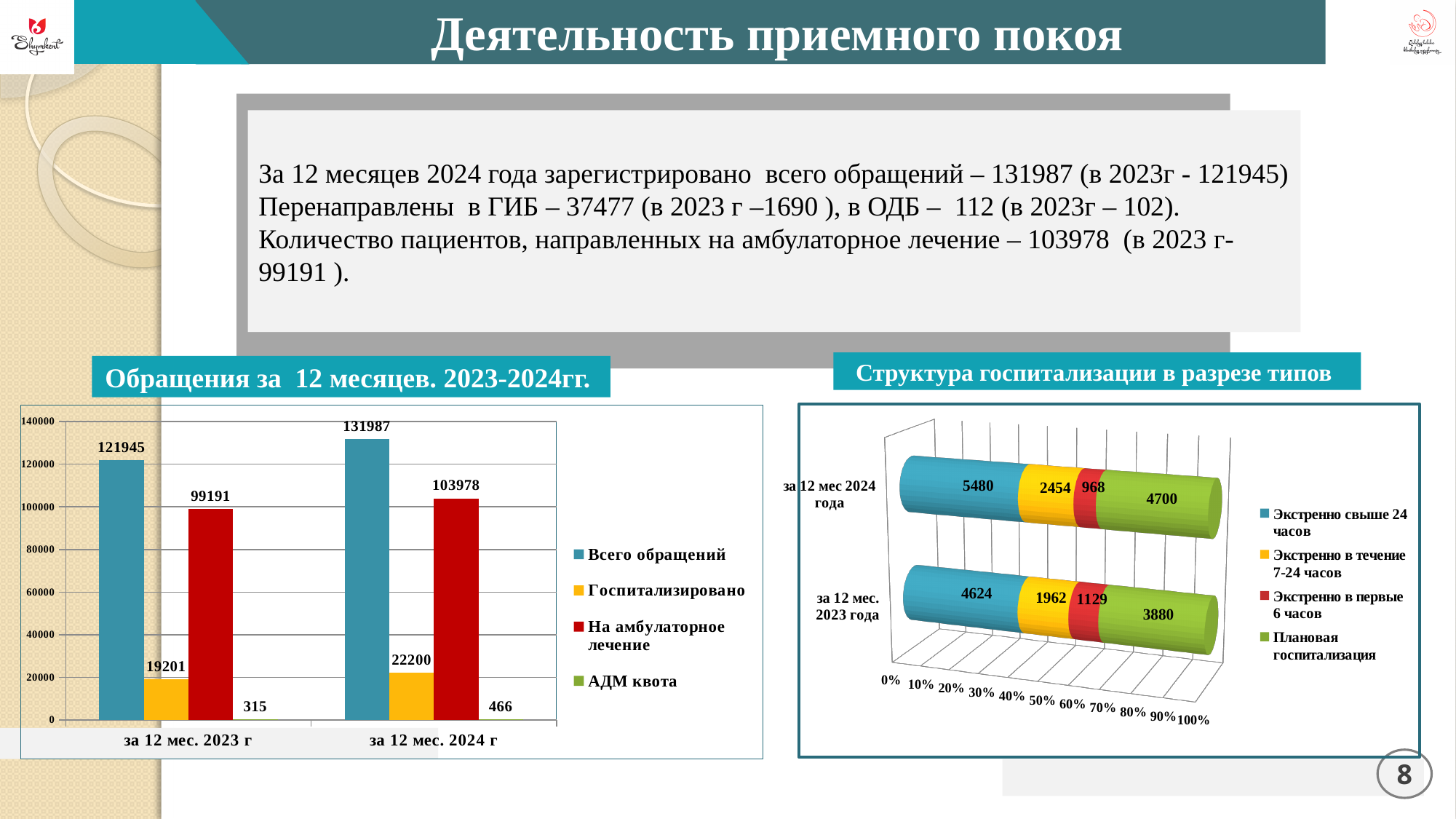
In the chart 'Обращения за 12 месяцев. 2023-2024гг.', what is the difference between 'На амбулаторное лечение' in 2024 and in 2023? 4787 In the chart 'Структура госпитализации в разрезе типов', what is the value of 'Плановая госпитализация' for 'за 12 мес 2024 года'? 4700 In the chart 'Структура госпитализации в разрезе типов', what is the value of 'Экстренно в первые 6 часов' for 'за 12 мес. 2023 года'? 1129 In the chart 'Структура госпитализации в разрезе типов', which is larger: 'Экстренно свыше 24 часов' in 2024 or in 2023? 2024 (5480) In the chart 'Обращения за 12 месяцев. 2023-2024гг.', what is the value of 'Всего обращений' for 'за 12 мес. 2024 г'? 131987 What type of chart is 'Обращения за 12 месяцев. 2023-2024гг.'? Bar chart In the chart 'Обращения за 12 месяцев. 2023-2024гг.', which series has the lowest value for 'за 12 мес. 2023 г'? АДМ квота In the chart 'Структура госпитализации в разрезе типов', how many categories (bars) are shown? 2 In the chart 'Обращения за 12 месяцев. 2023-2024гг.', how many series does the legend list? 4 In the chart 'Обращения за 12 месяцев. 2023-2024гг.', what is the value of 'Госпитализировано' for 'за 12 мес. 2023 г'? 19201 In the chart 'Обращения за 12 месяцев. 2023-2024гг.', what is the value of 'АДМ квота' for 'за 12 мес. 2024 г'? 466 In the chart 'Структура госпитализации в разрезе типов', what is the total of the stacked bar for 'за 12 мес 2024 года'? 13602